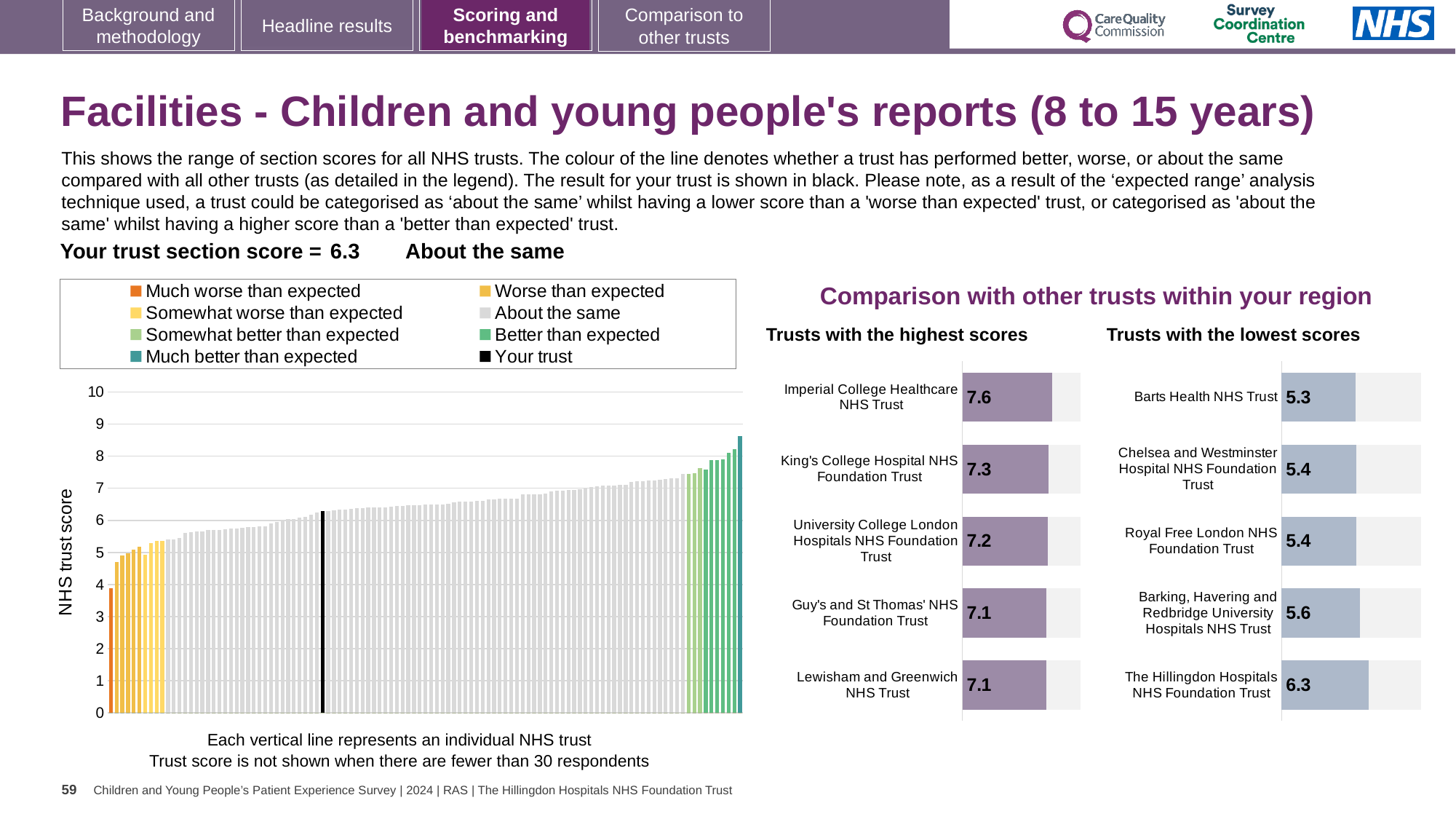
In the 'Trusts with the highest scores' chart, what is the difference between the scores of Imperial College Healthcare NHS Trust and King's College Hospital NHS Foundation Trust? 0.3 In the 'Trusts with the lowest scores' chart, what is the score for The Hillingdon Hospitals NHS Foundation Trust? 6.3 In the 'Trusts with the highest scores' chart, which trust has the highest score? Imperial College Healthcare NHS Trust In the 'Trusts with the lowest scores' chart, which has the larger score: Barking, Havering and Redbridge University Hospitals NHS Trust or Barts Health NHS Trust? Barking, Havering and Redbridge University Hospitals NHS Trust How many entries does the legend of the large chart on the left list? 8 In the 'Trusts with the highest scores' chart, what is the score for King's College Hospital NHS Foundation Trust? 7.3 What kind of chart is the large chart on the left showing the range of section scores? Bar chart In the 'Trusts with the lowest scores' chart, which trust has the lowest score? Barts Health NHS Trust In the 'Trusts with the lowest scores' chart, what is the score for Barts Health NHS Trust? 5.3 How many trusts are shown in the 'Trusts with the lowest scores' chart? 5 In the large chart on the left showing the range of section scores, is the value of the tallest bar greater or less than 8? greater In the 'Trusts with the highest scores' chart, what is the score for Imperial College Healthcare NHS Trust? 7.6